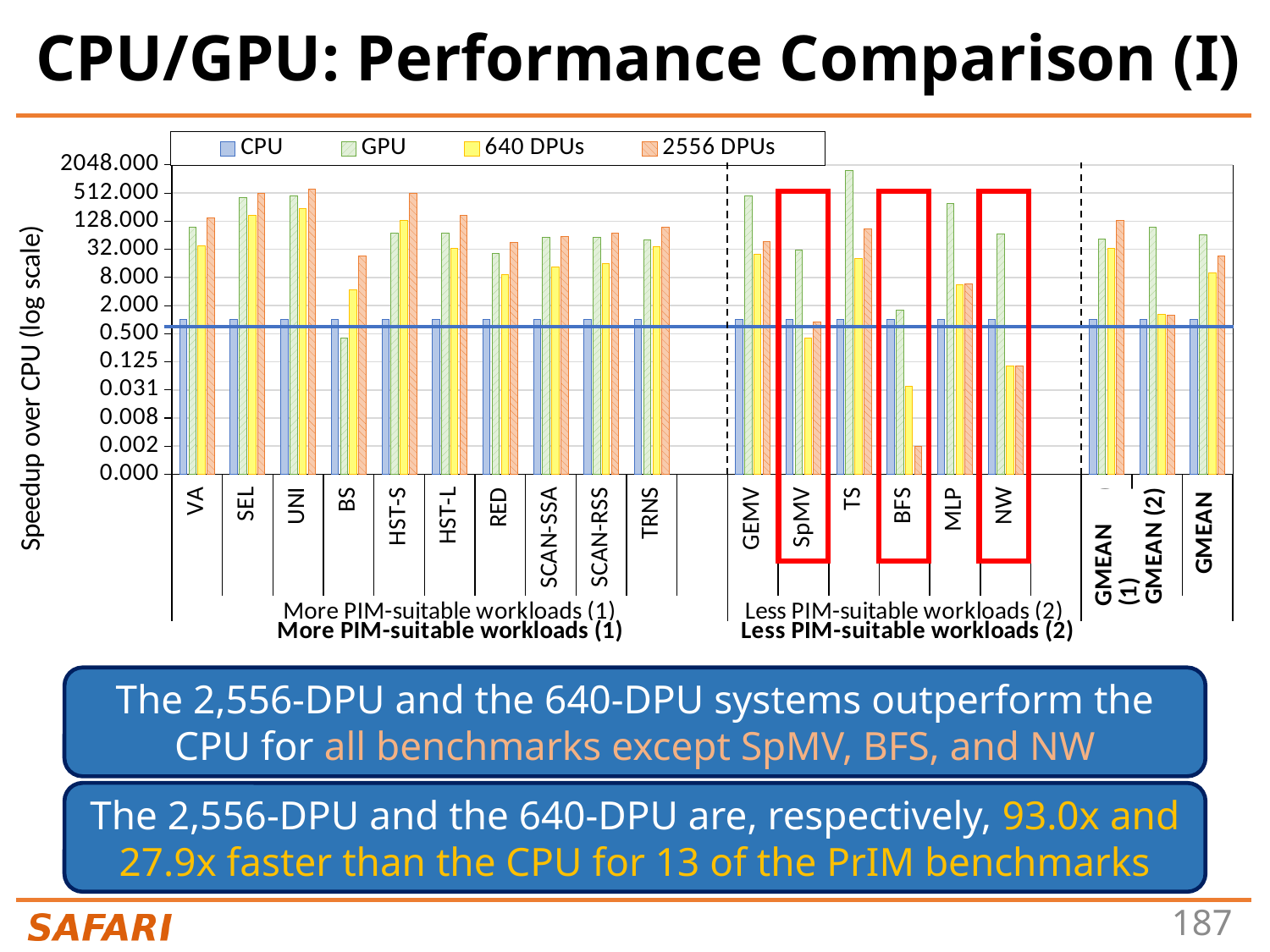
Which benchmark has the highest GPU bar? TS Is the 2556 DPUs value for BFS greater or less than 0.008? less Is the 640 DPUs value for NW greater or less than 0.500? less What is the label of the y axis? Speedup over CPU (log scale) How many benchmark categories (including the GMEAN bars) are shown along the x axis? 19 Which three benchmarks are highlighted with red boxes on the chart? SpMV, BFS, and NW How many series does the chart legend list? 4 For TS, which series has the higher value: GPU or 2556 DPUs? GPU Is the 2556 DPUs value for SEL greater or less than 128.000? greater Which benchmark has the lowest 2556 DPUs bar? BFS What kind of chart is shown on the slide? bar chart